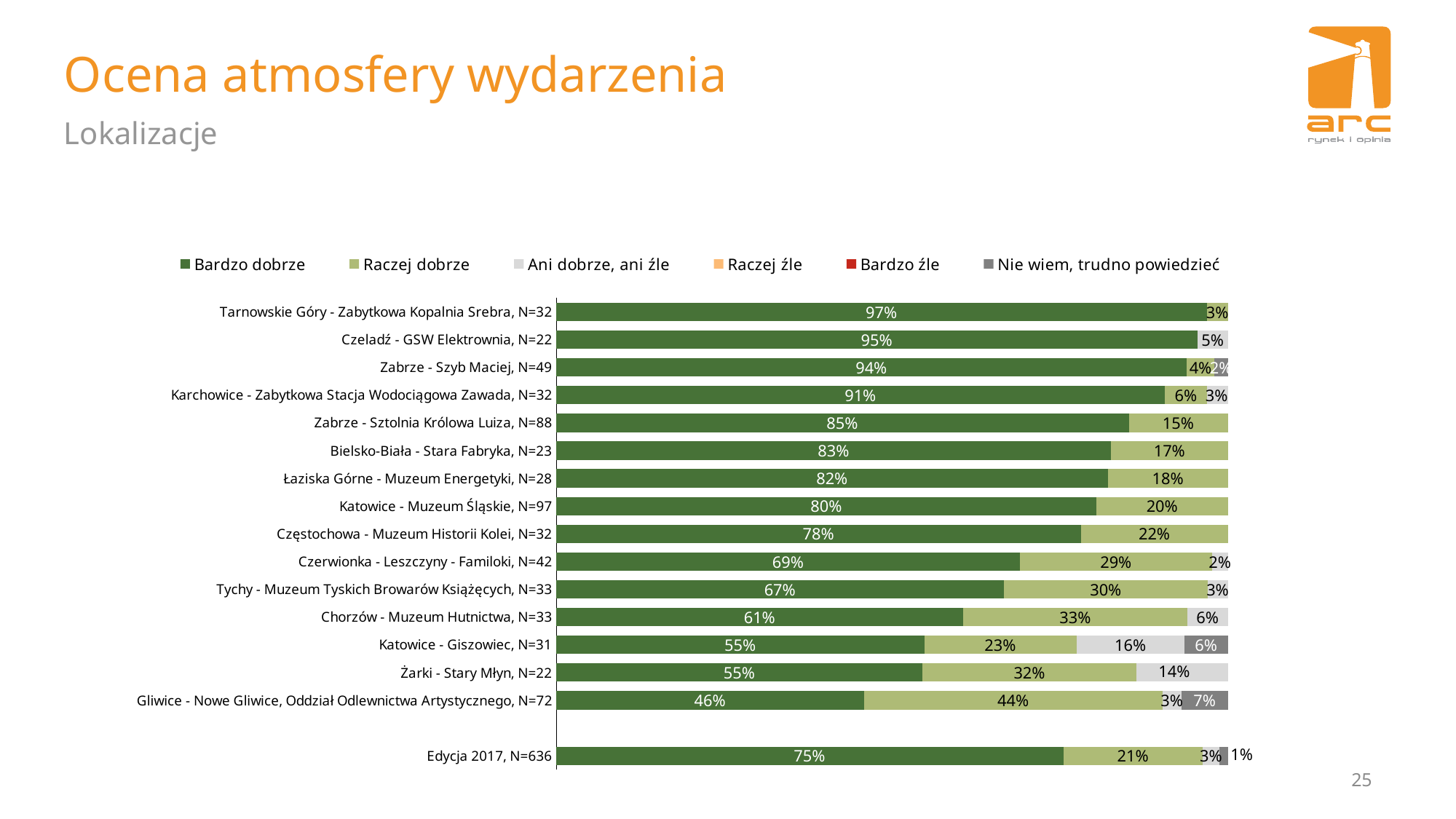
What is the 'Ani dobrze, ani źle' share for Katowice - Giszowiec, N=31? 16% Which has a larger 'Raczej dobrze' share: Gliwice - Nowe Gliwice, Oddział Odlewnictwa Artystycznego, N=72 or Żarki - Stary Młyn, N=22? Gliwice - Nowe Gliwice, Oddział Odlewnictwa Artystycznego, N=72 Which location has the lowest 'Bardzo dobrze' share? Gliwice - Nowe Gliwice, Oddział Odlewnictwa Artystycznego, N=72 What is the 'Nie wiem, trudno powiedzieć' share for Gliwice - Nowe Gliwice, Oddział Odlewnictwa Artystycznego, N=72? 7% Which location has the highest 'Bardzo dobrze' share? Tarnowskie Góry - Zabytkowa Kopalnia Srebra, N=32 How many bars are shown in the chart, including Edycja 2017? 16 What is the 'Raczej dobrze' share for Chorzów - Muzeum Hutnictwa, N=33? 33% What is the 'Bardzo dobrze' share for Edycja 2017, N=636? 75% What type of chart is shown on the slide? Stacked bar chart What is the difference in 'Bardzo dobrze' share between Czeladź - GSW Elektrownia, N=22 and Tychy - Muzeum Tyskich Browarów Książęcych, N=33? 28 percentage points What percentage of respondents rated the atmosphere 'Bardzo dobrze' at Katowice - Muzeum Śląskie, N=97? 80% How many series does the legend list? 6